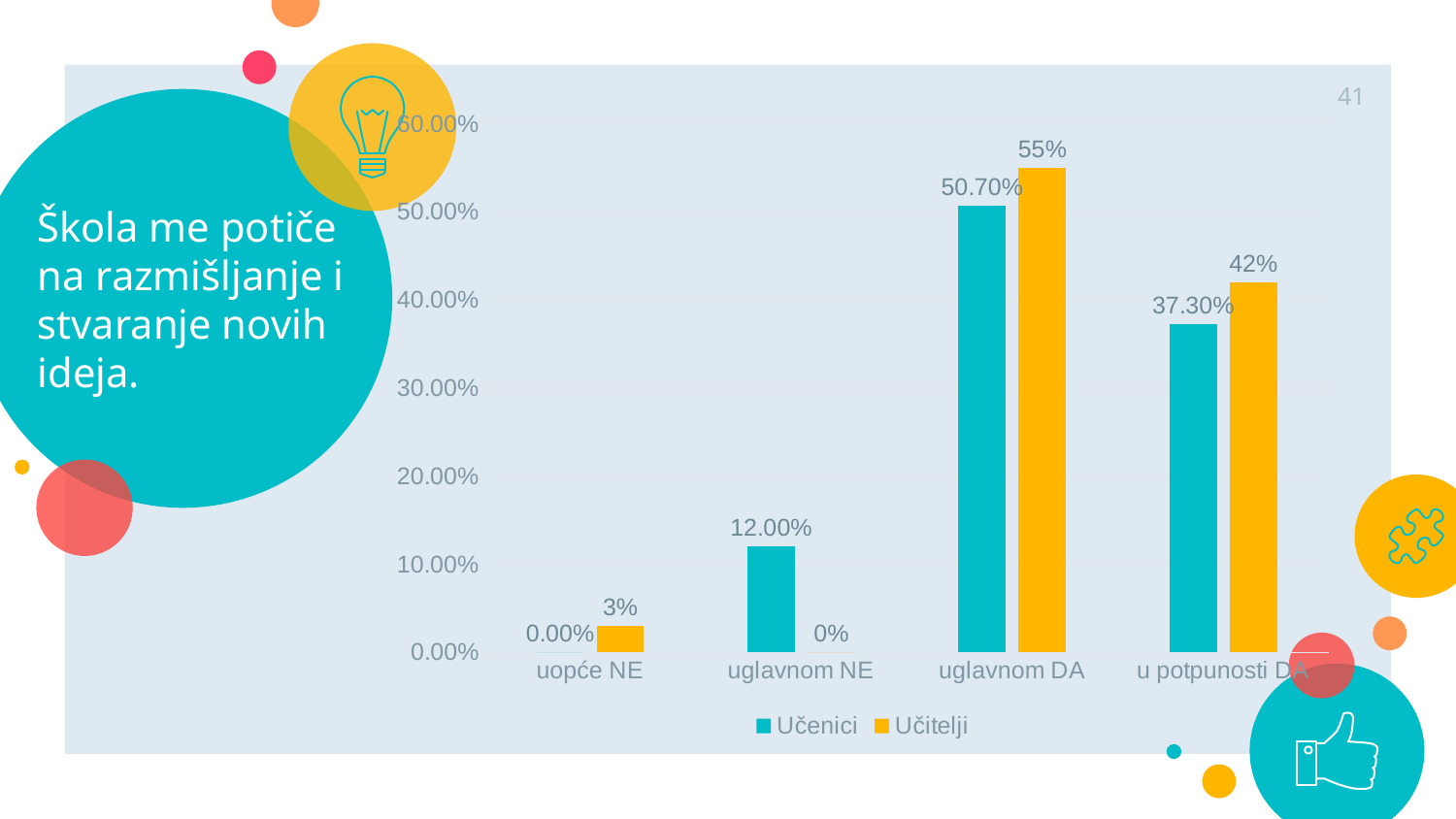
Which category has the lowest Učenici value? uopće NE Which series is shown in orange in the legend? Učitelji How many series does the legend list? 2 Which category has the highest Učitelji value? uglavnom DA What is the difference between the Učitelji and Učenici values for 'uglavnom DA'? 4.30 percentage points What kind of chart is shown on the slide? bar chart What is the Učitelji value for 'uopće NE'? 3% For 'u potpunosti DA', which series has the larger value, Učenici or Učitelji? Učitelji What is the Učitelji value for 'u potpunosti DA'? 42% What is the Učenici value for 'uglavnom DA'? 50.70% How many categories are shown on the x axis? 4 What is the Učenici value for 'uglavnom NE'? 12.00%